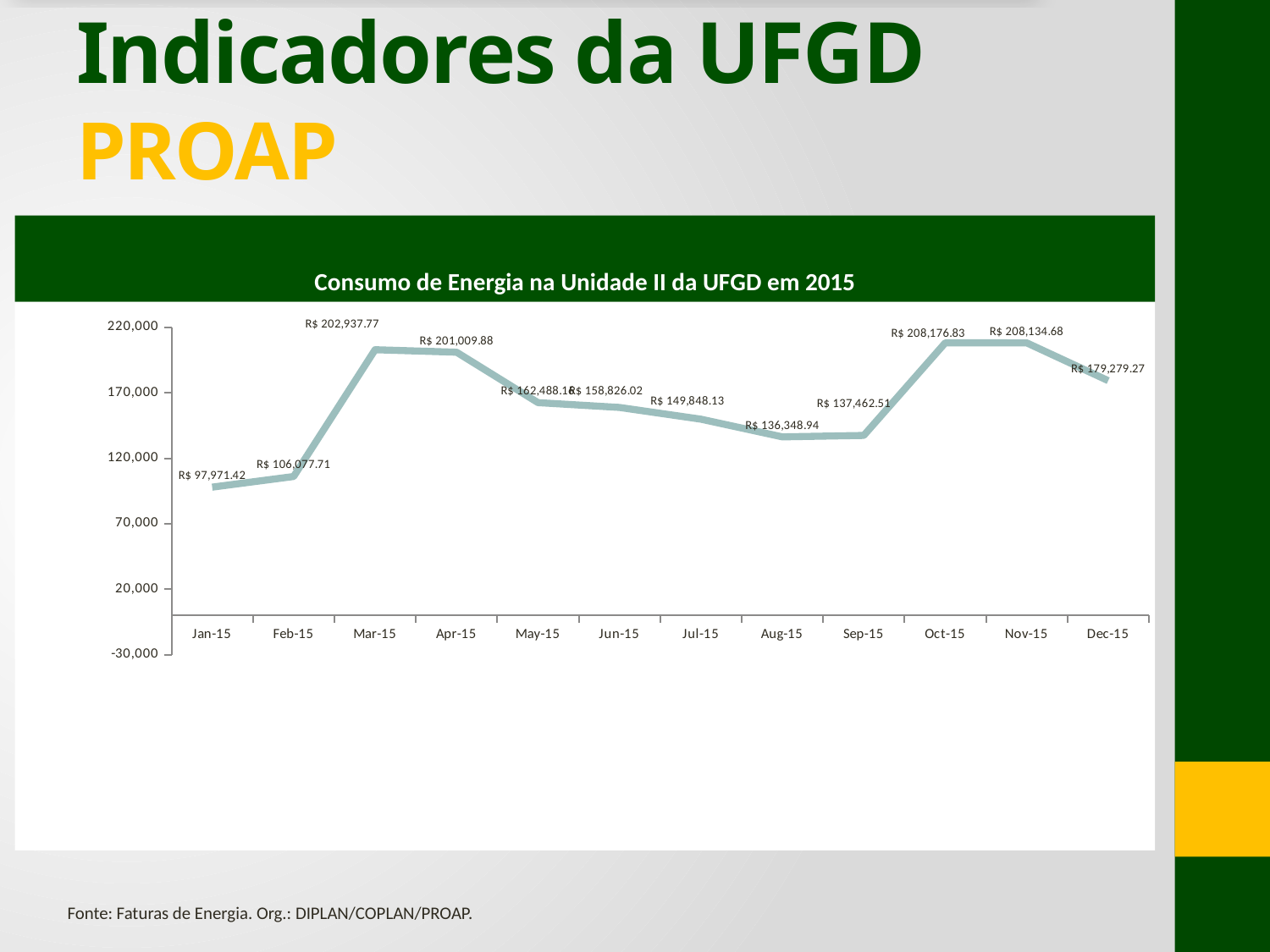
What is the difference between the values for Mar-15 and Feb-15? R$ 96,860.06 Which month has the lowest value? Jan-15 What is the difference between the values for Nov-15 and Dec-15? R$ 28,855.41 What kind of chart is shown on the slide? line chart How many months are plotted on the x axis? 12 Which is larger, the value for Jul-15 or the value for Aug-15? Jul-15 Is the value for Jul-15 greater or less than 170,000? less Do the values rise or fall from Jun-15 to Aug-15? fall Is the value for Oct-15 greater or less than 170,000? greater What is the value for Mar-15 in the chart 'Consumo de Energia na Unidade II da UFGD em 2015'? R$ 202,937.77 What is the value for Dec-15? R$ 179,279.27 What is the value for Aug-15? R$ 136,348.94